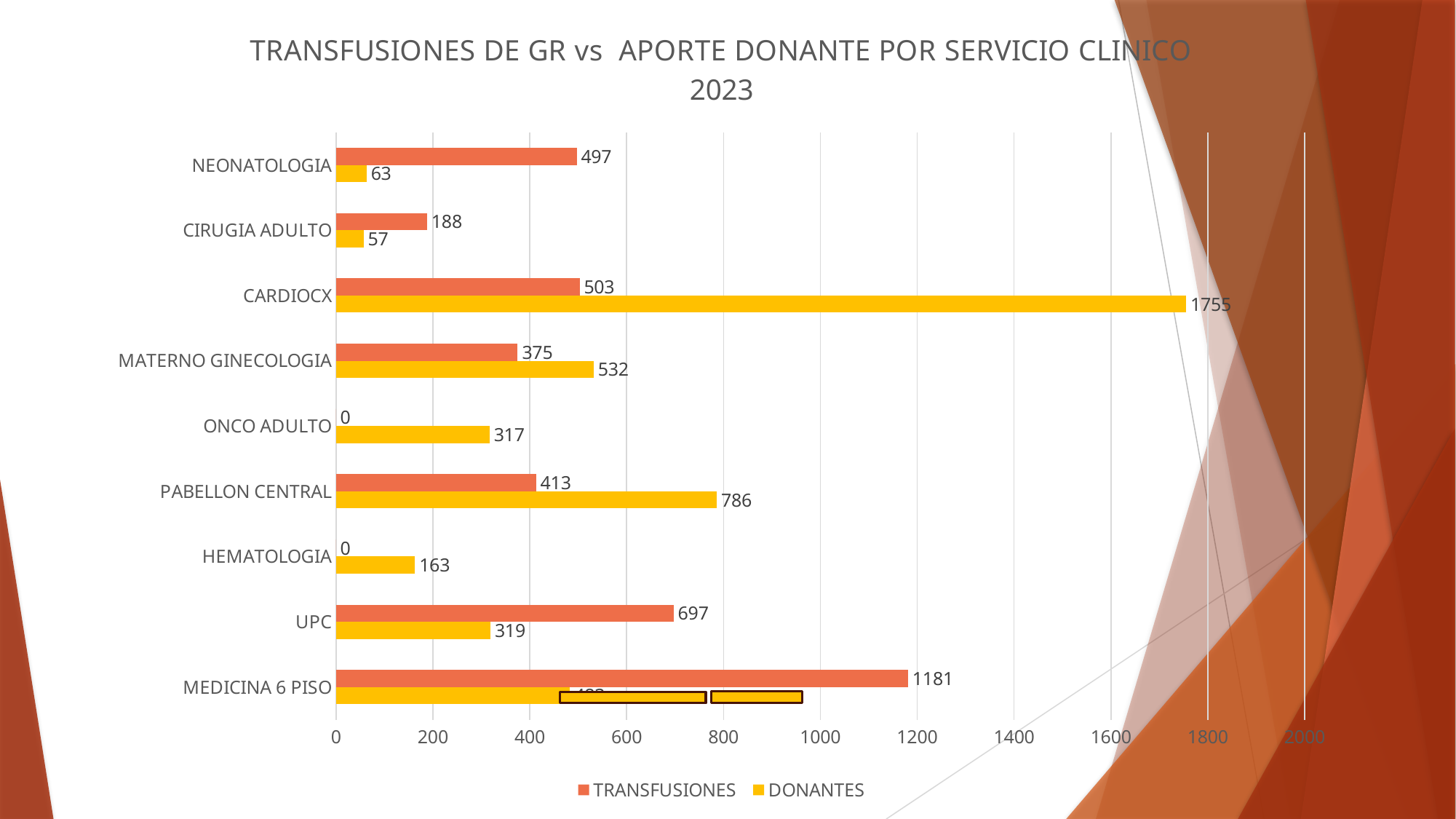
What is the TRANSFUSIONES value for UPC? 697 For MATERNO GINECOLOGIA, which is larger: TRANSFUSIONES or DONANTES? DONANTES How many series does the legend list? 2 What is the difference between the DONANTES and TRANSFUSIONES values for CARDIOCX? 1252 What type of chart is shown on the slide? bar chart How many clinical services (categories) are shown on the chart? 9 Which service has the lowest DONANTES value? CIRUGIA ADULTO What is the TRANSFUSIONES value for NEONATOLOGIA? 497 Which service has the highest DONANTES value? CARDIOCX What is the DONANTES value for PABELLON CENTRAL? 786 Which service has the highest TRANSFUSIONES value? MEDICINA 6 PISO What is the DONANTES value for CARDIOCX? 1755